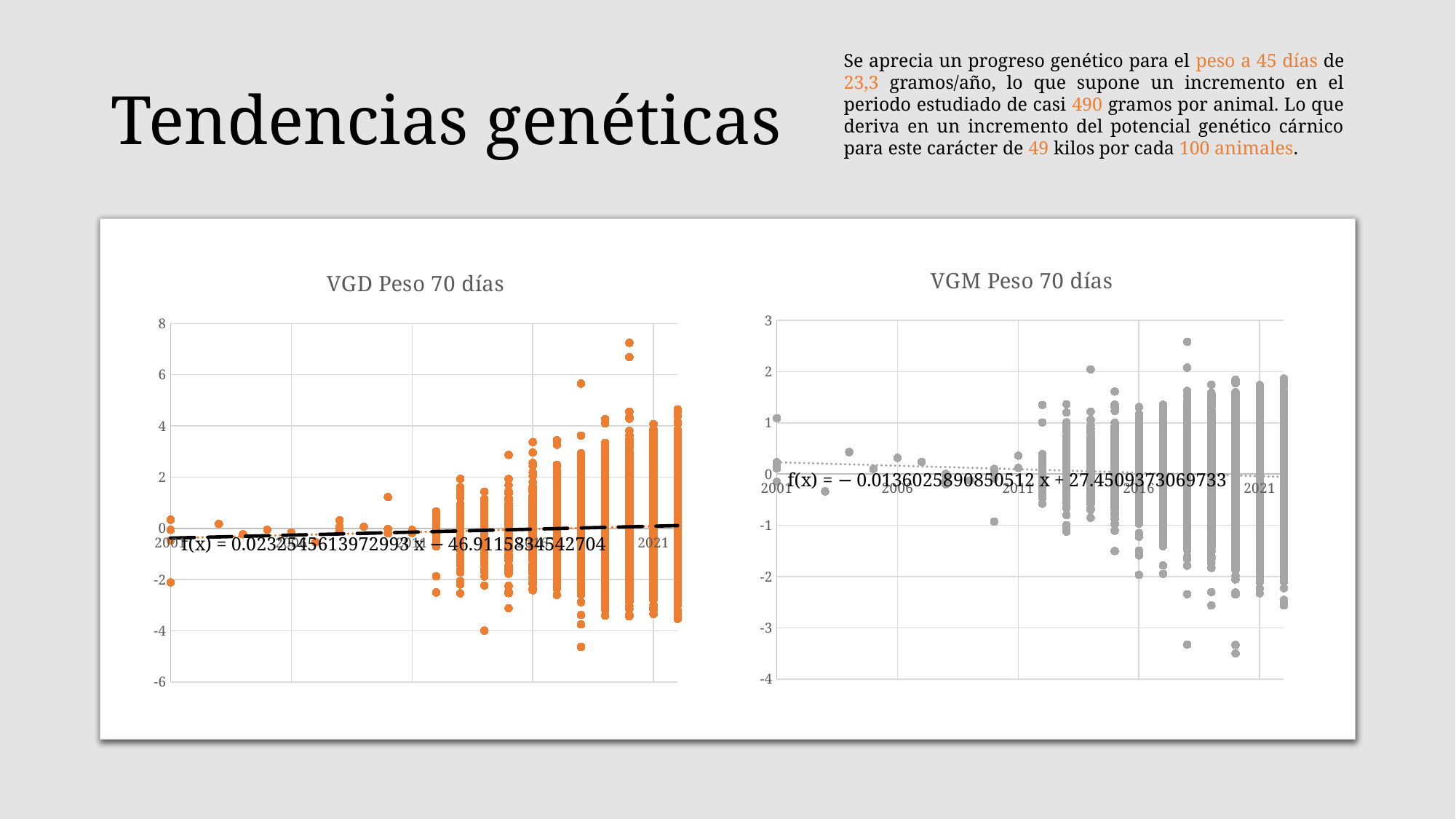
In the 'VGD Peso 70 días' chart, is the lowest plotted point greater or less than -4? less In the 'VGD Peso 70 días' chart, does the dashed trendline rise or fall from 2001 to 2021? rise What is the trendline equation shown on the 'VGD Peso 70 días' chart? f(x) = 0.0232545613972993 x − 46.9115834542704 In the 'VGD Peso 70 días' chart, is the highest plotted point greater or less than 6? greater What kind of chart is the 'VGM Peso 70 días' chart on the right? scatter chart What is the trendline equation shown on the 'VGM Peso 70 días' chart? f(x) = − 0.0136025890850512 x + 27.4509373069733 What colour are the data points in the 'VGD Peso 70 días' chart? orange In the 'VGM Peso 70 días' chart, is the lowest plotted point greater or less than -3? less In the 'VGM Peso 70 días' chart, does the dotted trendline rise or fall from 2001 to 2021? fall What kind of chart is the 'VGD Peso 70 días' chart on the left? scatter chart What is the title of the chart on the right of the slide? VGM Peso 70 días